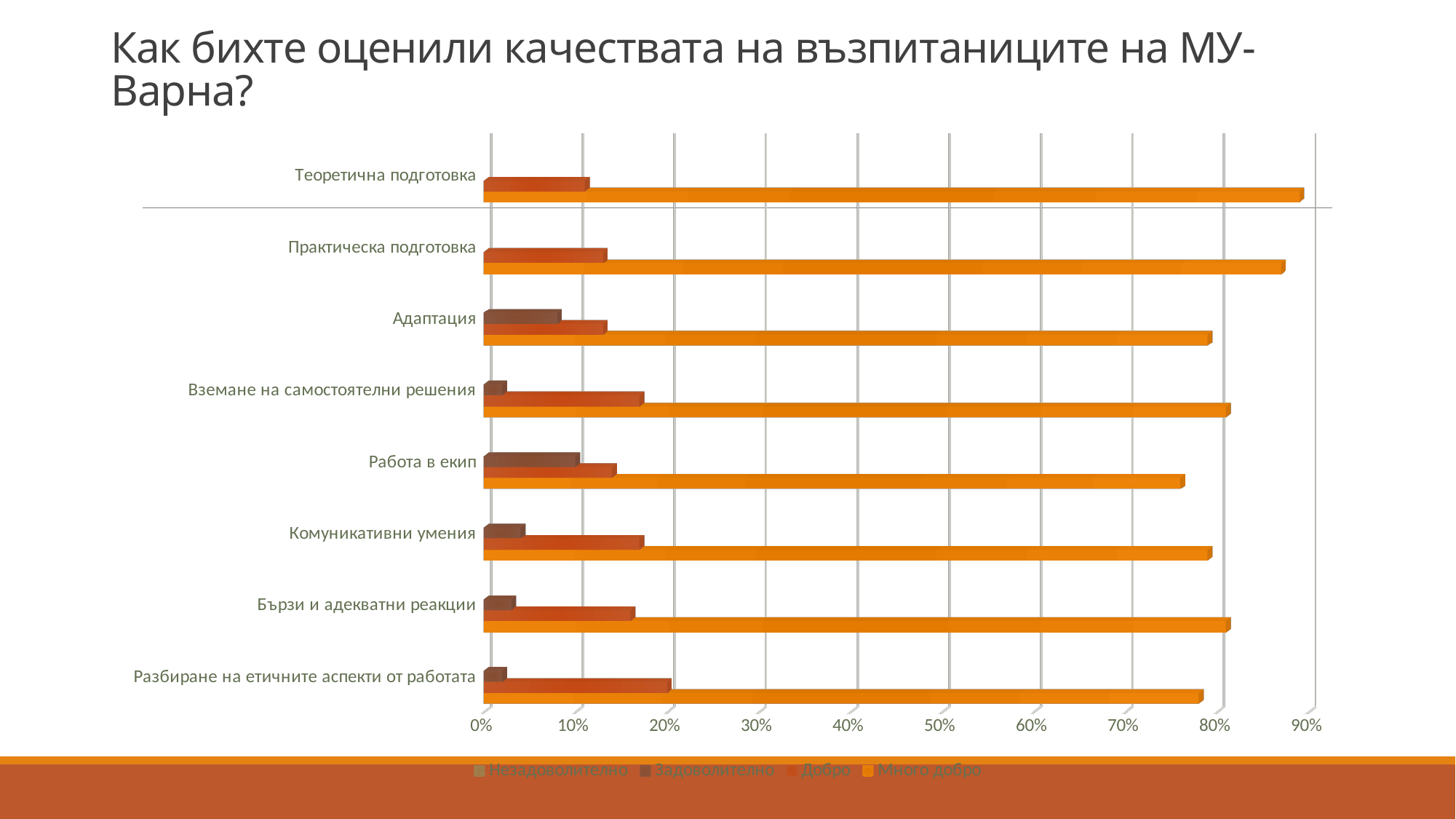
Which category has the highest 'Задоволително' value? Работа в екип What is the last series listed in the chart legend? Много добро What kind of chart is shown on the slide? Bar chart Which has the larger 'Добро' value: 'Разбиране на етичните аспекти от работата' or 'Теоретична подготовка'? Разбиране на етичните аспекти от работата Is the 'Много добро' value for 'Работа в екип' greater or less than 80%? less Is the 'Задоволително' value for 'Адаптация' greater or less than 10%? less Which has the larger 'Много добро' value: 'Теоретична подготовка' or 'Работа в екип'? Теоретична подготовка Which category has the highest 'Добро' value? Разбиране на етичните аспекти от работата How many series does the chart legend list? 4 Is the 'Много добро' value for 'Теоретична подготовка' greater or less than 80%? greater How many categories (qualities) are listed on the vertical axis of the chart? 8